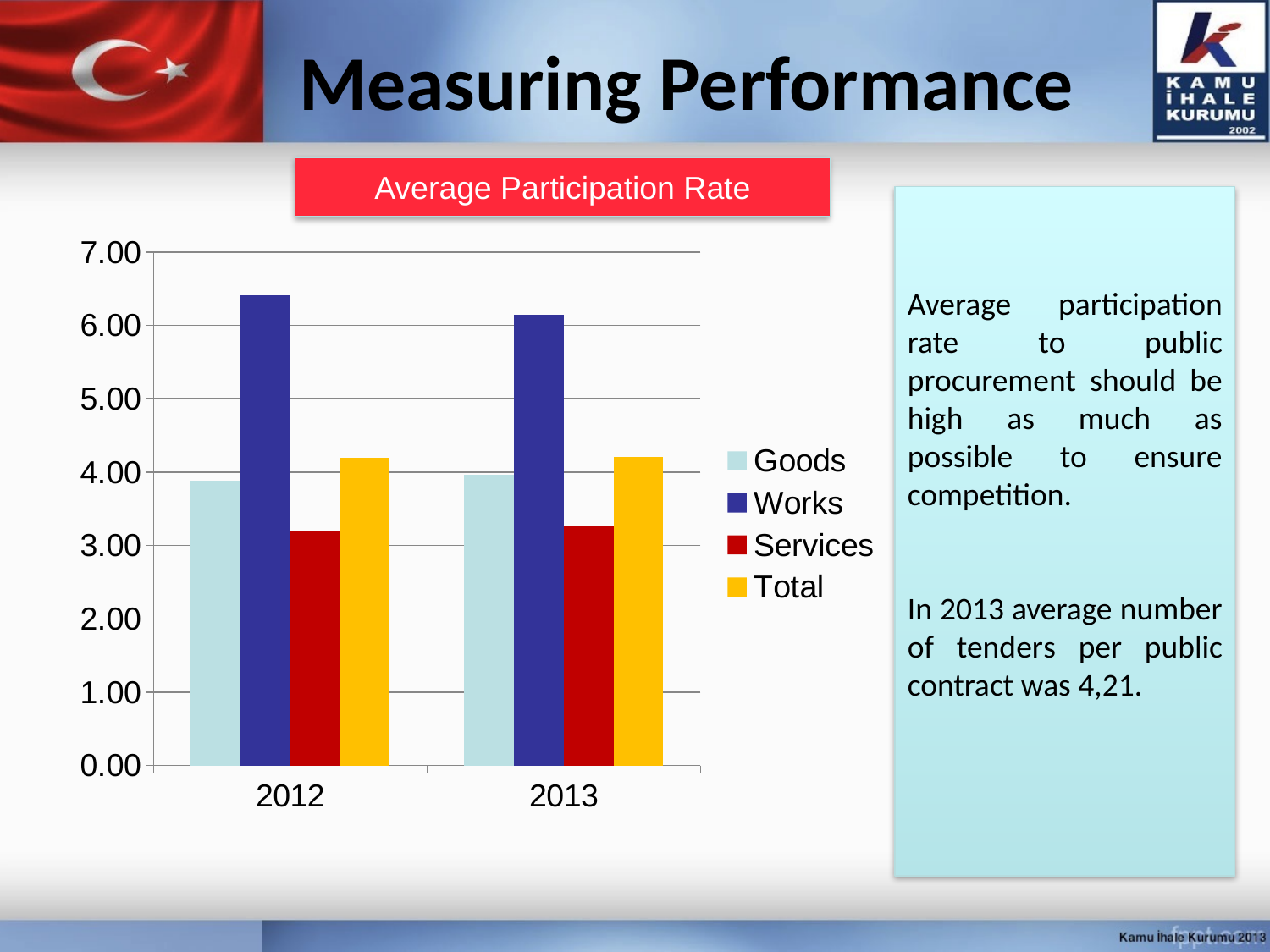
Which series has the highest value in 2012 in the Average Participation Rate chart? Works Is the value for Services in 2012 greater or less than 3.00? greater Which series has the lowest value in 2013 in the Average Participation Rate chart? Services Is the value for Goods in 2012 greater or less than 4.00? less Which is larger in the Average Participation Rate chart: Works in 2012 or Works in 2013? Works in 2012 Does the Works series rise or fall from 2012 to 2013? fall Is the value for Total in 2013 greater or less than 4.00? greater What type of chart is shown under the heading 'Average Participation Rate'? bar chart How many year categories are shown on the x axis of the Average Participation Rate chart? 2 How many series does the legend of the Average Participation Rate chart list? 4 What colour represents the Total series in the Average Participation Rate chart? yellow